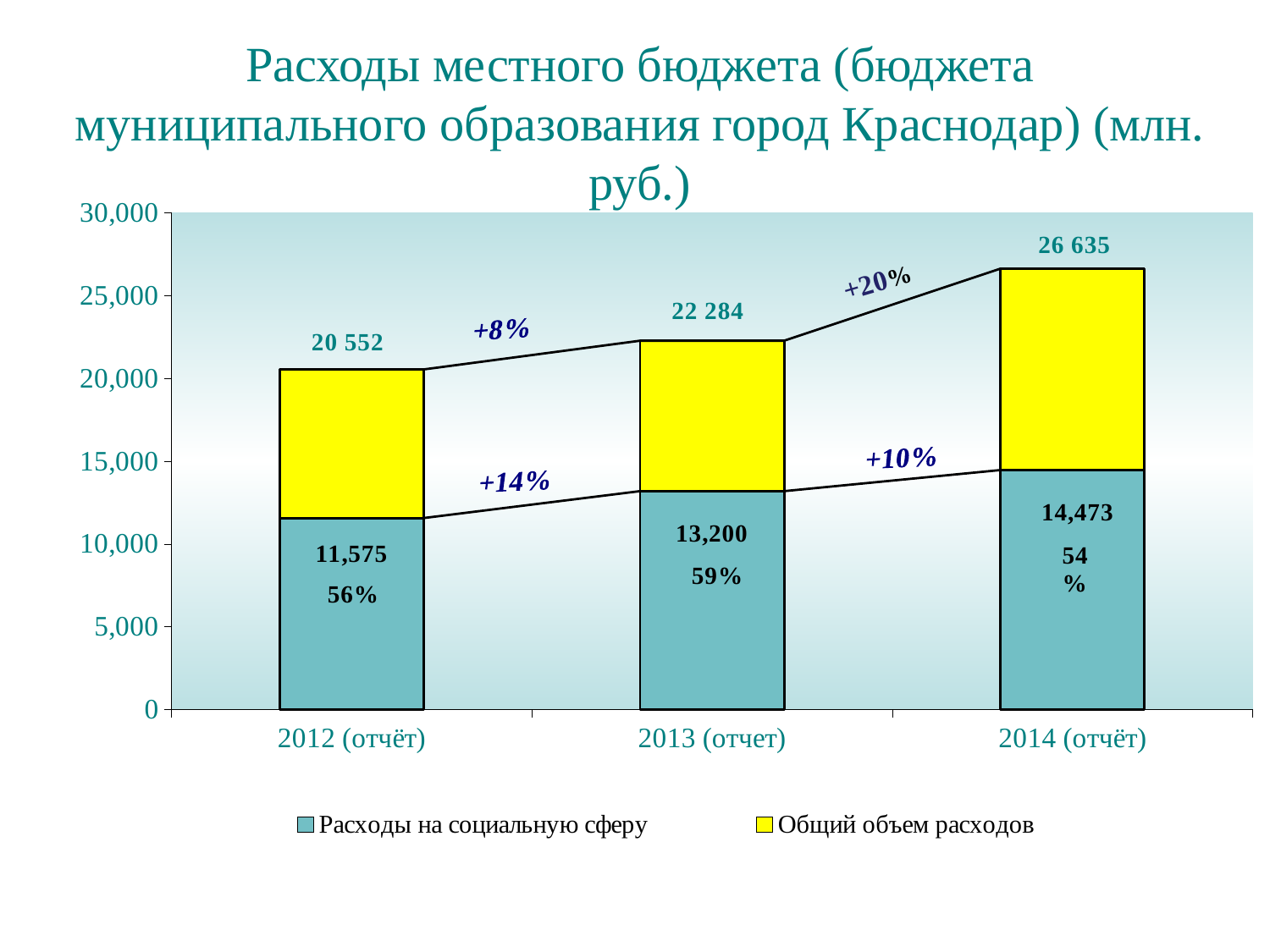
What kind of chart is shown on the slide? Stacked bar chart What is the value for Расходы на социальную сферу in 2014 (отчёт)? 14,473 Is the total expenditure value for 2014 (отчёт) greater or less than 25,000? greater How many series does the legend list? 2 What total expenditure value is labelled above the 2013 (отчет) bar? 22 284 What is the value for Расходы на социальную сферу in 2012 (отчёт)? 11,575 How many years are shown on the x axis? 3 What growth percentage is shown between the 2013 and 2014 total expenditure values? +20% Which year has the highest value for Расходы на социальную сферу? 2014 (отчёт) What percentage is shown inside the Расходы на социальную сферу segment for 2013 (отчет)? 59% What is the difference between the Расходы на социальную сферу values for 2013 (отчет) and 2012 (отчёт)? 1,625 Which year has the lowest total expenditure value? 2012 (отчёт)